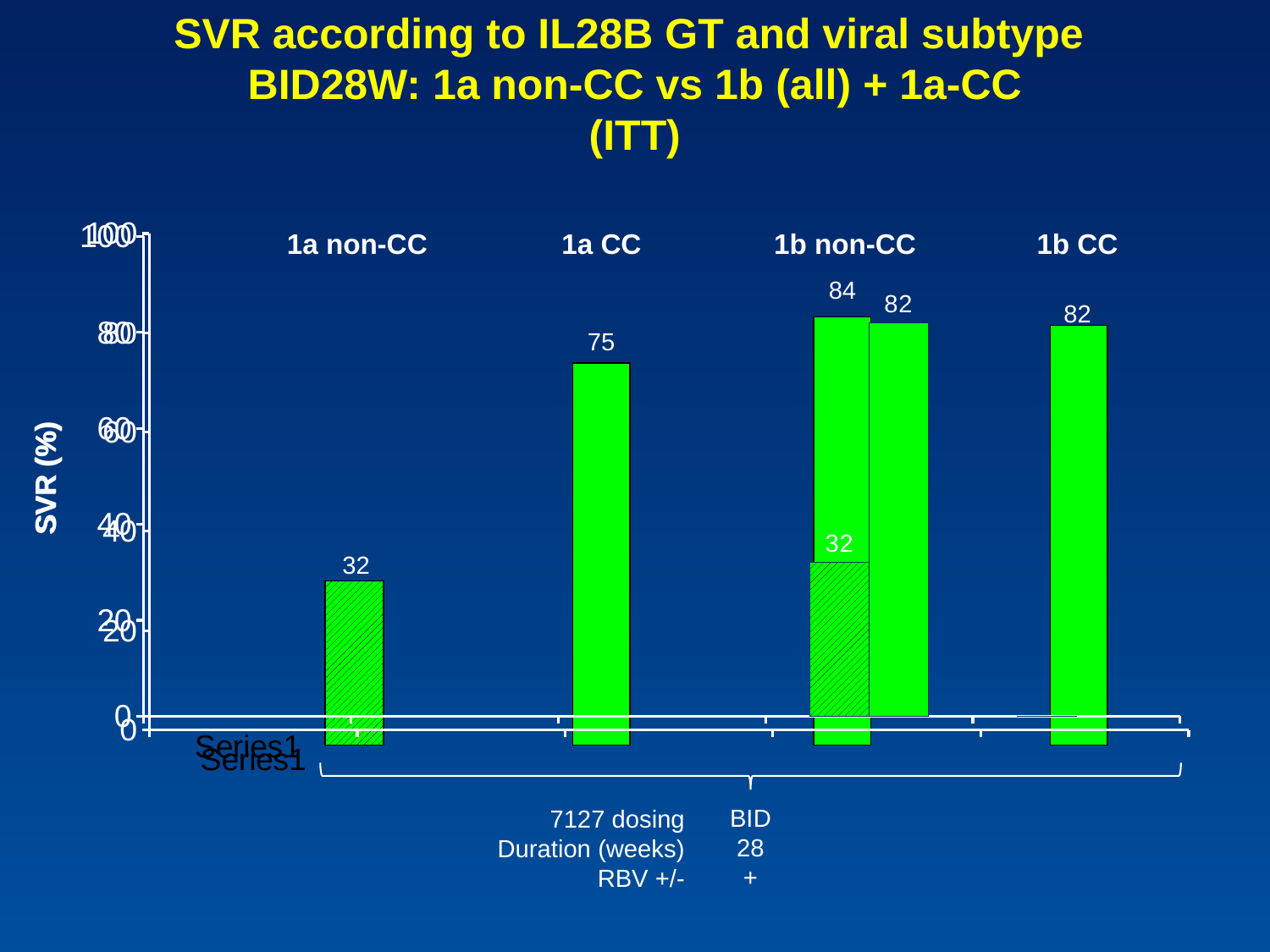
What is the highest SVR value labelled on the chart? 84 Which group has the higher SVR value, 1a CC or 1b CC? 1b CC How many IL28B genotype/viral subtype groups are labelled across the top of the chart? 4 What is the SVR (%) value shown for the 1b CC group? 82 What is the SVR (%) value shown for the 1a non-CC group? 32 What kind of chart is shown on the slide? bar chart Is the SVR value for 1a CC greater or less than 60? greater What is the difference between the SVR values for 1a CC and 1a non-CC? 43 What is the title of the vertical axis? SVR (%) What is the difference between the SVR values for 1b CC and 1a non-CC? 50 What is the SVR (%) value shown for the 1a CC group? 75